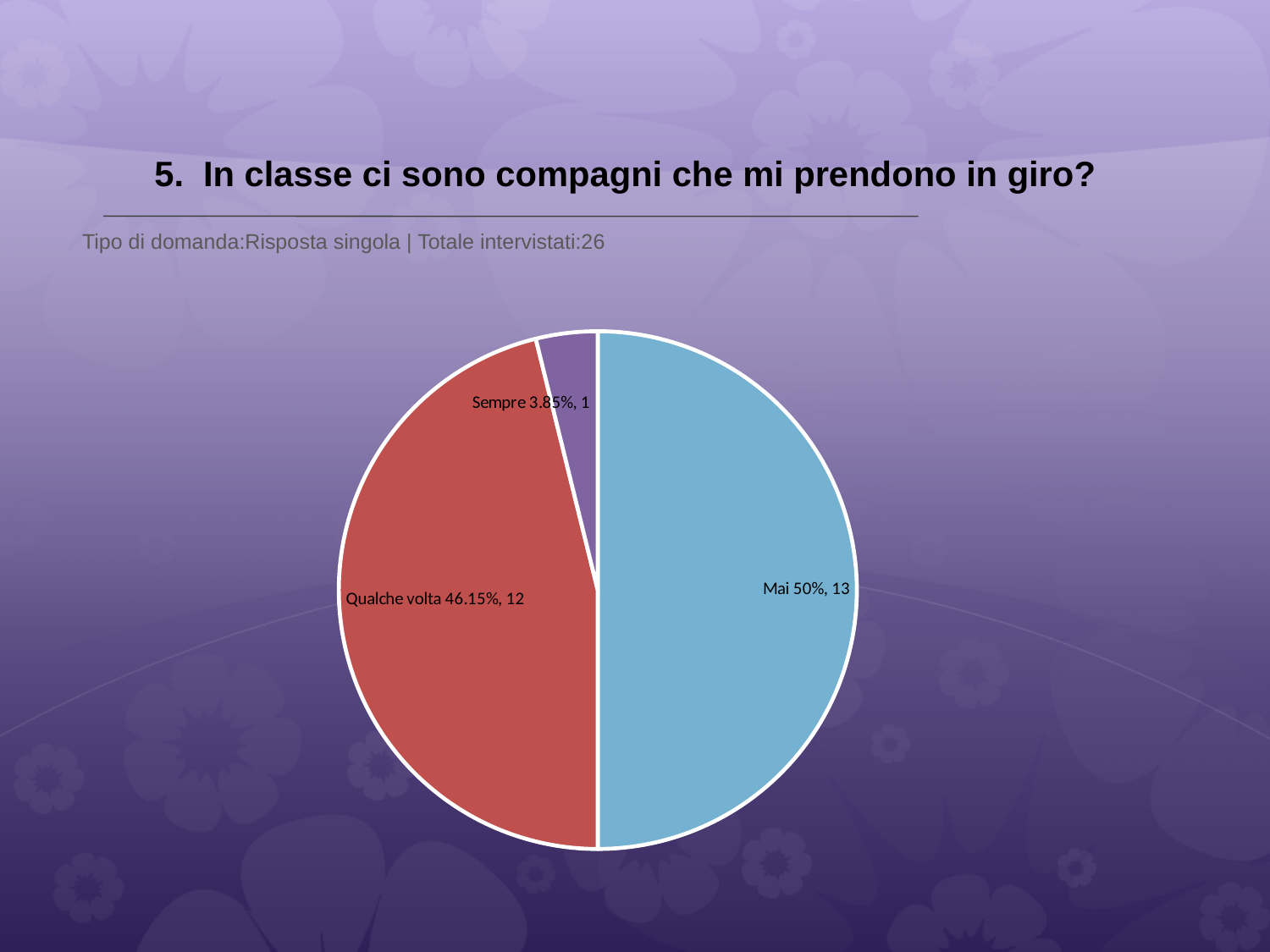
What is the count for "Mai"? 13 What is the difference in count between "Mai" and "Qualche volta"? 1 What percentage share does "Qualche volta" have? 46.15% What percentage share does "Sempre" have? 3.85% Which is larger, the count for "Qualche volta" or the count for "Sempre"? Qualche volta Which category has the smallest slice? Sempre What colour is the "Mai" slice? blue What is the count for "Sempre"? 1 Which category has the largest slice? Mai How many slices does the pie chart have? 3 What kind of chart is shown on the slide? pie chart What is the total number of respondents across all slices? 26